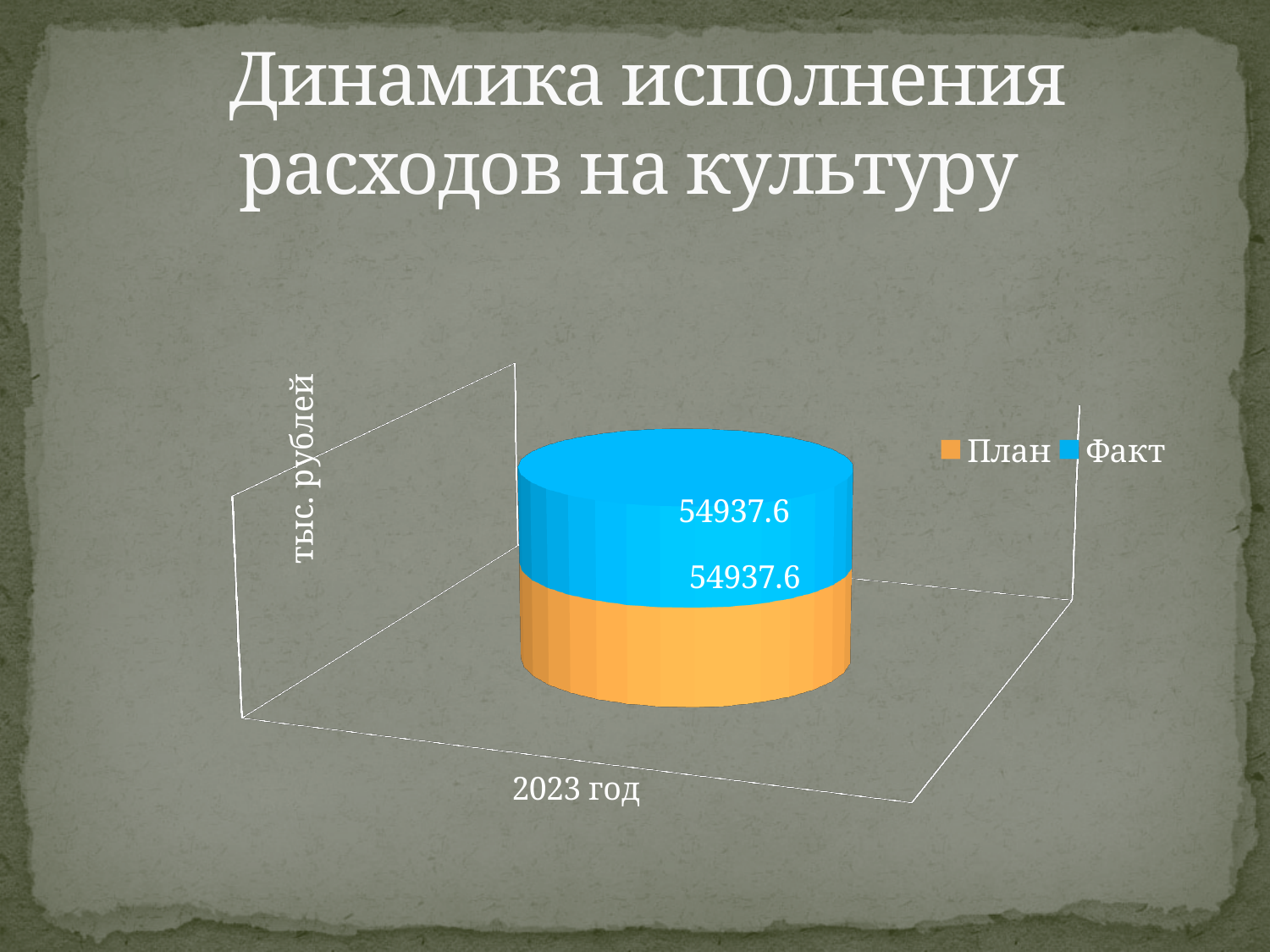
What is the total of the stacked bar for 2023 год? 109875.2 What is the difference between the План and Факт values for 2023 год? 0 Which series is shown in blue? Факт What is the title of the chart on the slide? Динамика исполнения расходов на культуру What is the value for Факт in 2023 год? 54937.6 How many series does the legend list? 2 What unit is shown on the vertical axis label? тыс. рублей What kind of chart is shown on the slide? bar chart Which category label is shown on the x axis? 2023 год What is the value for План in 2023 год? 54937.6 How many categories are shown on the x axis? 1